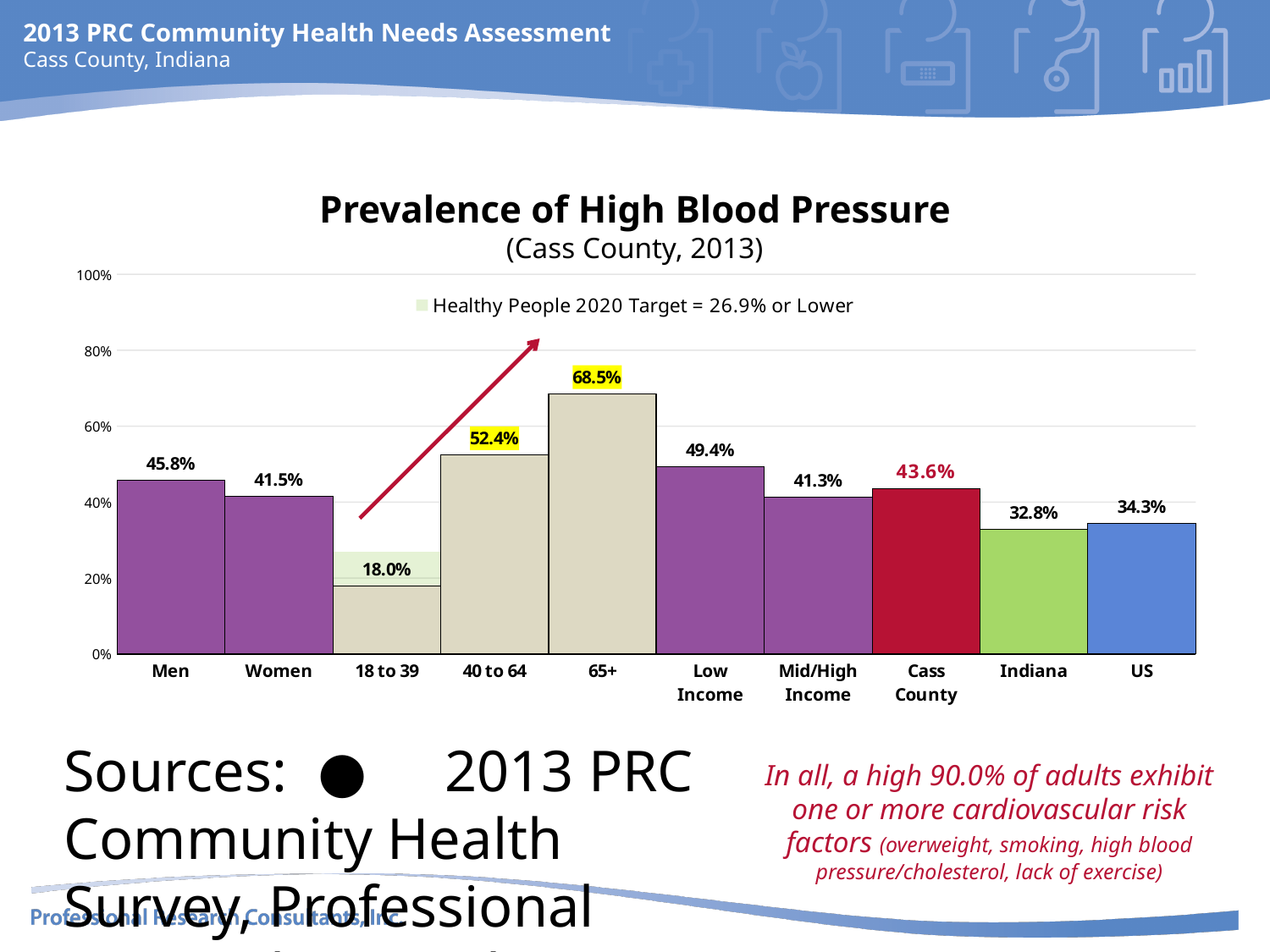
What is the difference between the values for Men and Women? 4.3% What is the value shown for Cass County? 43.6% What is the difference between the values for Cass County and the US? 9.3% What is the value shown for the 65+ age group? 68.5% What is the Healthy People 2020 Target stated in the chart legend? 26.9% or Lower What kind of chart is shown on the slide? Bar chart Which category has the highest prevalence of high blood pressure? 65+ What is the value shown for Indiana? 32.8% What is the prevalence of high blood pressure for Men? 45.8% Which is larger, the value for Low Income or Mid/High Income? Low Income How many categories are shown on the x axis? 10 Which category has the lowest prevalence of high blood pressure? 18 to 39